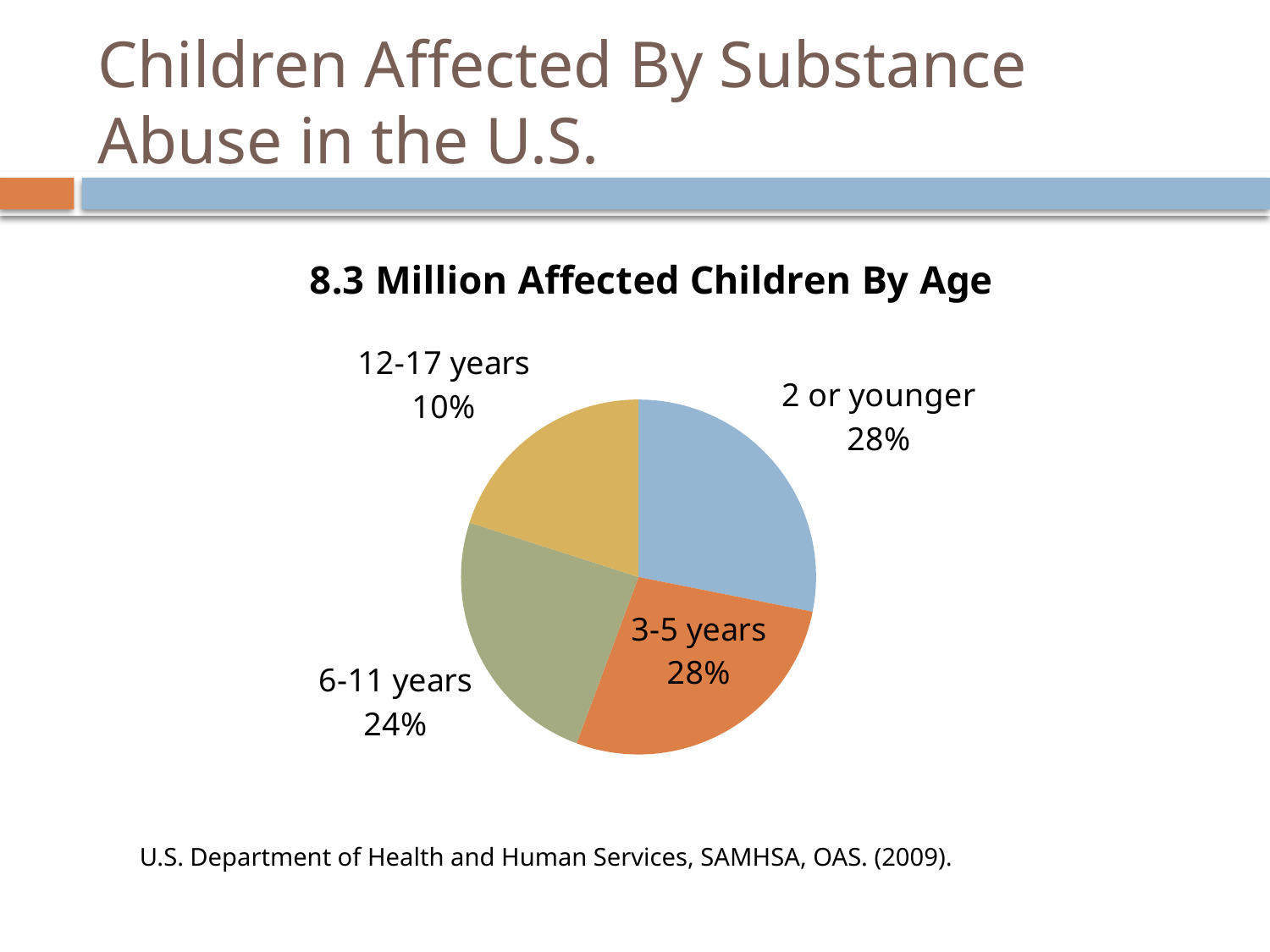
What is the title of the chart? 8.3 Million Affected Children By Age What is the difference in percentage points between the 6-11 years slice and the 12-17 years slice? 14 What is the difference in percentage points between the 2 or younger slice and the 6-11 years slice? 4 Which age group has the smallest share of affected children? 12-17 years What colour is the slice for 3-5 years? orange What share of affected children are 2 or younger? 28% What share of affected children are 6-11 years old? 24% What kind of chart is shown on the slide? pie chart How many age groups are shown in the pie chart? 4 Which is larger, the share for 6-11 years or the share for 12-17 years? 6-11 years What share of affected children are 12-17 years old? 10% What share of affected children are 3-5 years old? 28%